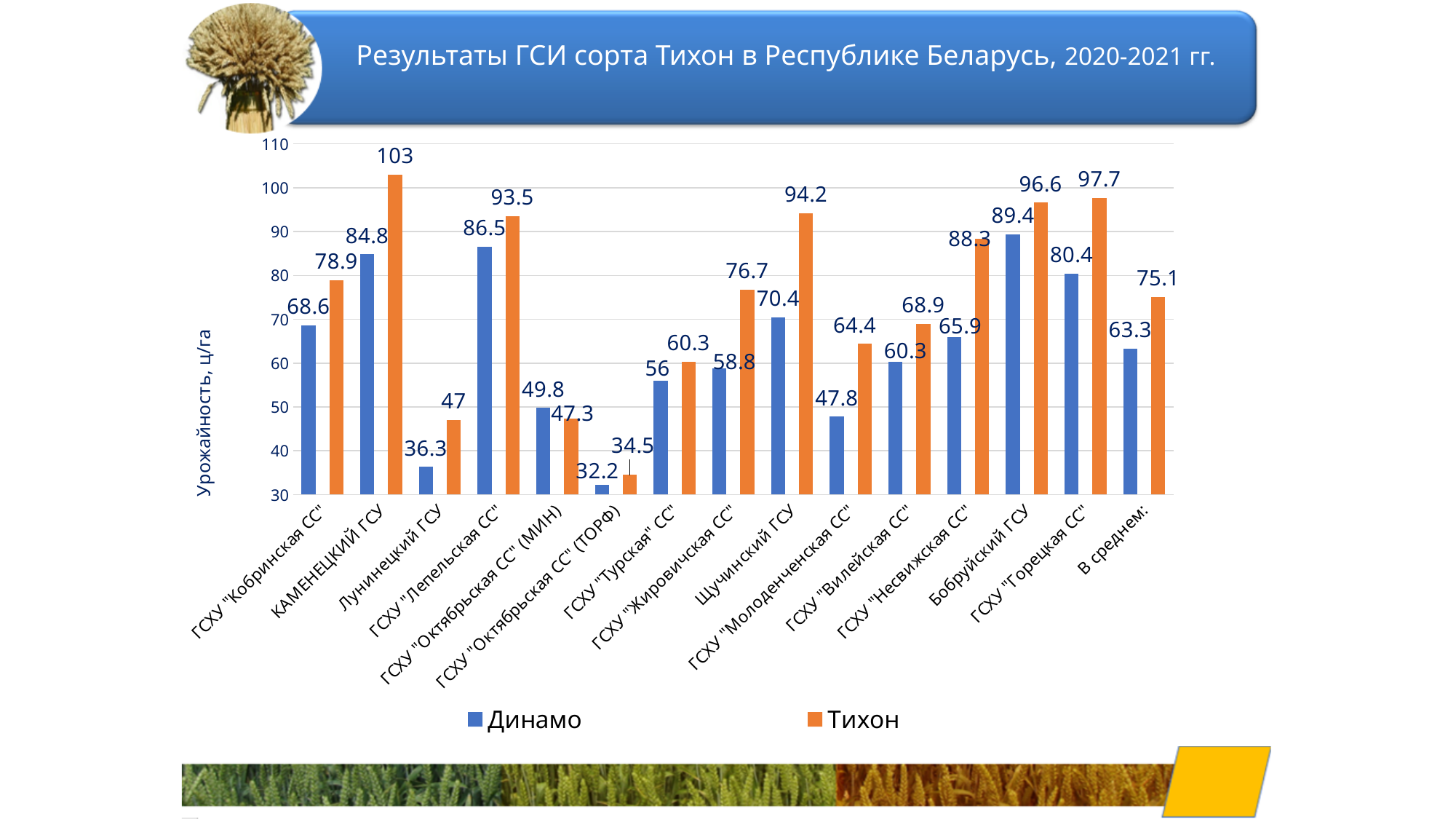
What is the difference between the average values of Тихон and Динамо (В среднем:)? 11.8 What is the value for Тихон at КАМЕНЕЦКИЙ ГСУ? 103 How many series does the legend list? 2 Which category has the lowest value for Динамо? ГСХУ "Октябрьская СС" (ТОРФ) What is the average (В среднем:) value for Тихон? 75.1 What is the difference between Тихон and Динамо at Щучинский ГСУ? 23.8 Which category has the highest value for Тихон? КАМЕНЕЦКИЙ ГСУ How many categories are shown on the x axis? 15 What type of chart is shown on the slide? bar chart What is the value for Динамо at Щучинский ГСУ? 70.4 Which is larger at ГСХУ "Октябрьская СС" (МИН): Динамо or Тихон? Динамо What is the y-axis title of the chart? Урожайность, ц/га